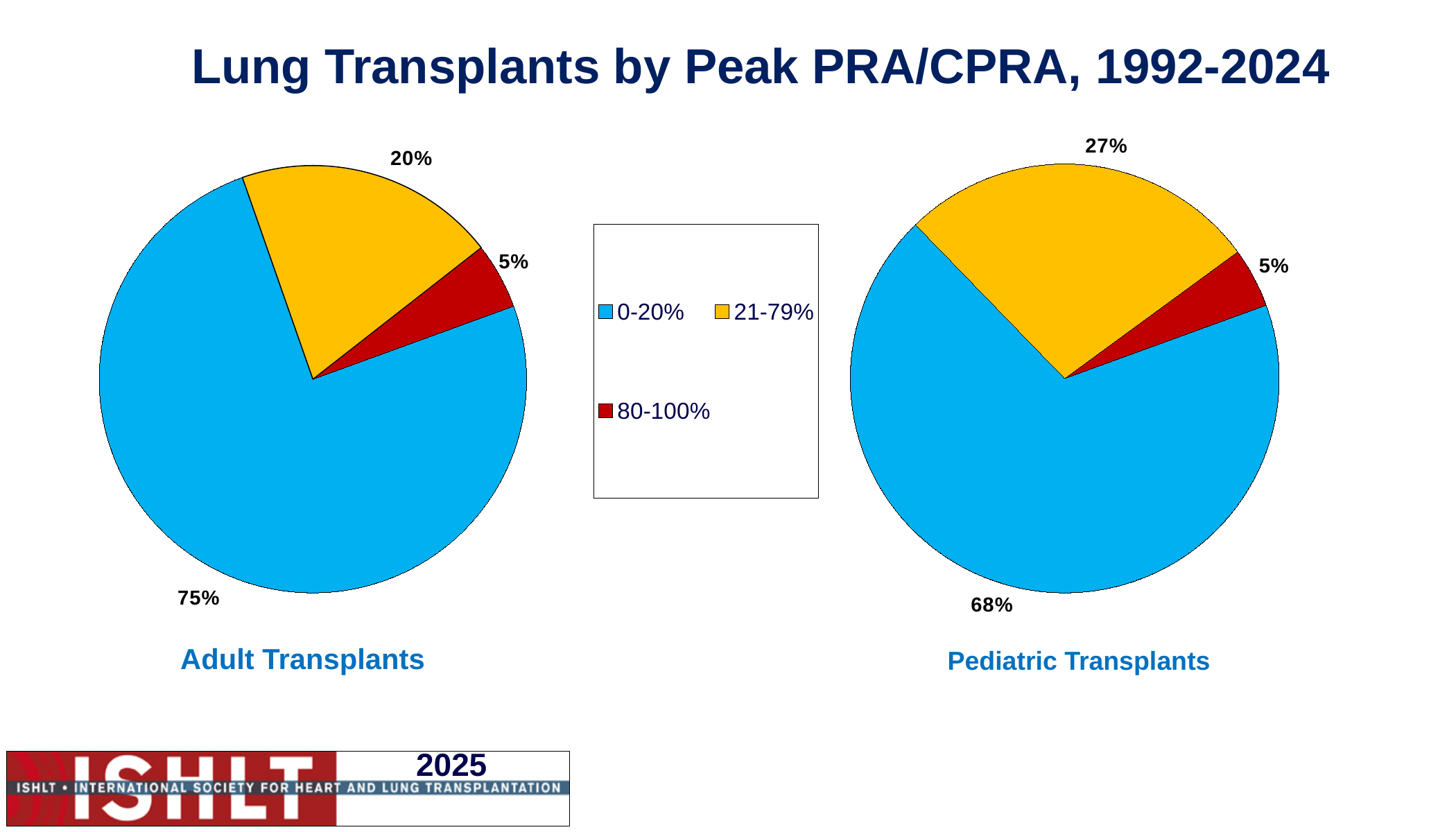
What type of chart is used for the Adult Transplants data? Pie chart In the Pediatric Transplants pie chart, what share of lung transplants had a peak PRA/CPRA of 0-20%? 68% In the Adult Transplants pie chart, what is the difference between the 21-79% share and the 80-100% share? 15% What is the difference between the 0-20% share in the Adult Transplants chart and the 0-20% share in the Pediatric Transplants chart? 7% In the Adult Transplants pie chart, what share of lung transplants had a peak PRA/CPRA of 80-100%? 5% Which chart shows a larger share for the 21-79% category, Adult Transplants or Pediatric Transplants? Pediatric Transplants What colour represents the 80-100% category in the pie charts? Red How many categories does the legend list for the pie charts? 3 In the Adult Transplants pie chart, which PRA/CPRA category has the largest share? 0-20% In the Adult Transplants pie chart, what share of lung transplants had a peak PRA/CPRA of 0-20%? 75% In the Pediatric Transplants pie chart, which PRA/CPRA category has the smallest share? 80-100%